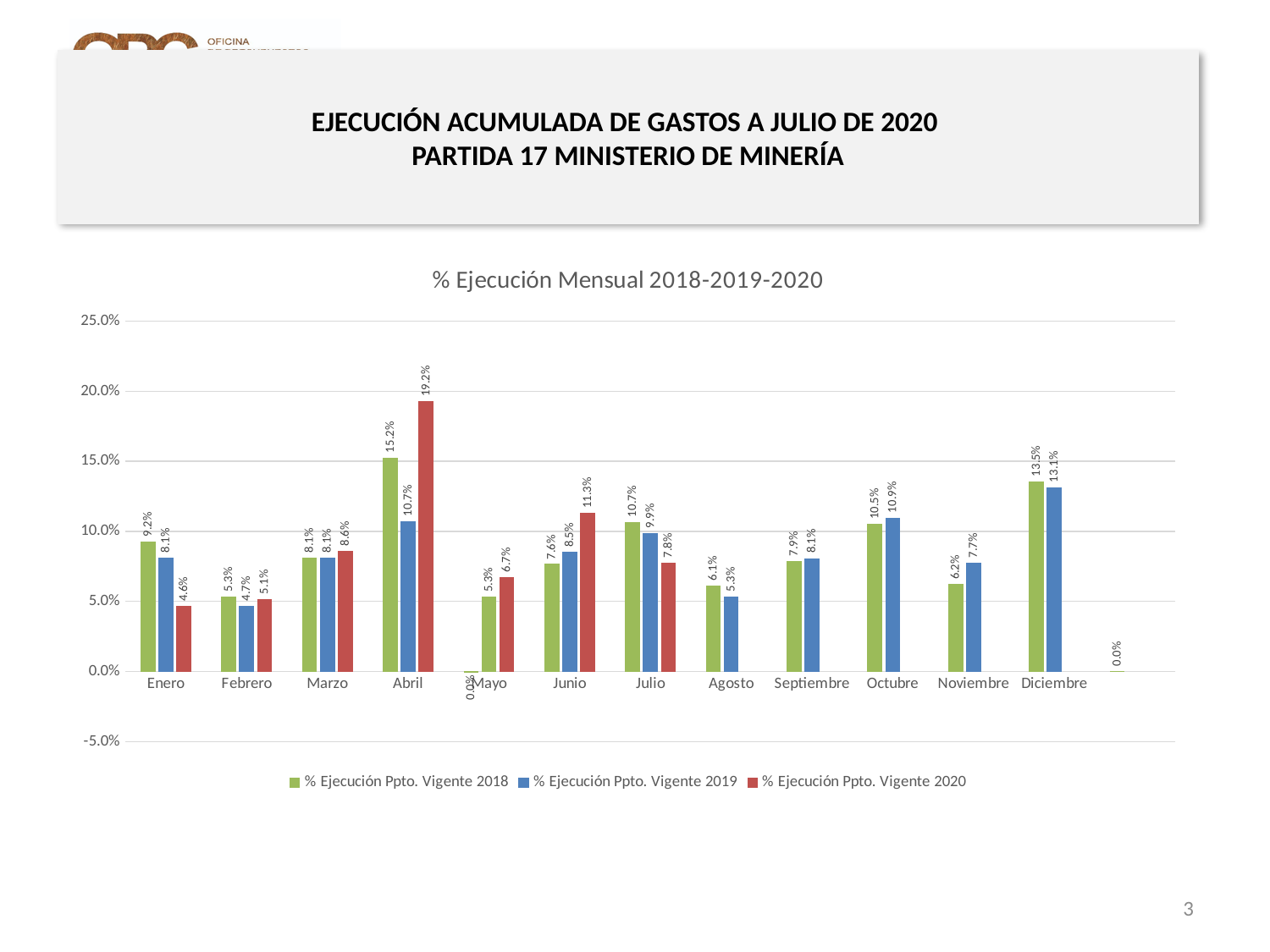
What is the difference between the 2020 and 2019 values for Abril? 8.5 percentage points How many series does the legend list? 3 What is the value for Mayo in the % Ejecución Ppto. Vigente 2018 series? 0.0% How many months are shown on the x axis? 12 Which month has the lowest value in the % Ejecución Ppto. Vigente 2019 series? Febrero What is the value for Abril in the % Ejecución Ppto. Vigente 2020 series? 19.2% What type of chart is shown on the slide? Bar chart What is the value for Enero in the % Ejecución Ppto. Vigente 2018 series? 9.2% For Julio, which series has the larger value: 2018 or 2019? 2018 What is the value for Diciembre in the % Ejecución Ppto. Vigente 2019 series? 13.1% Which month has the highest value in the % Ejecución Ppto. Vigente 2020 series? Abril Which month has the highest value in the % Ejecución Ppto. Vigente 2018 series? Abril